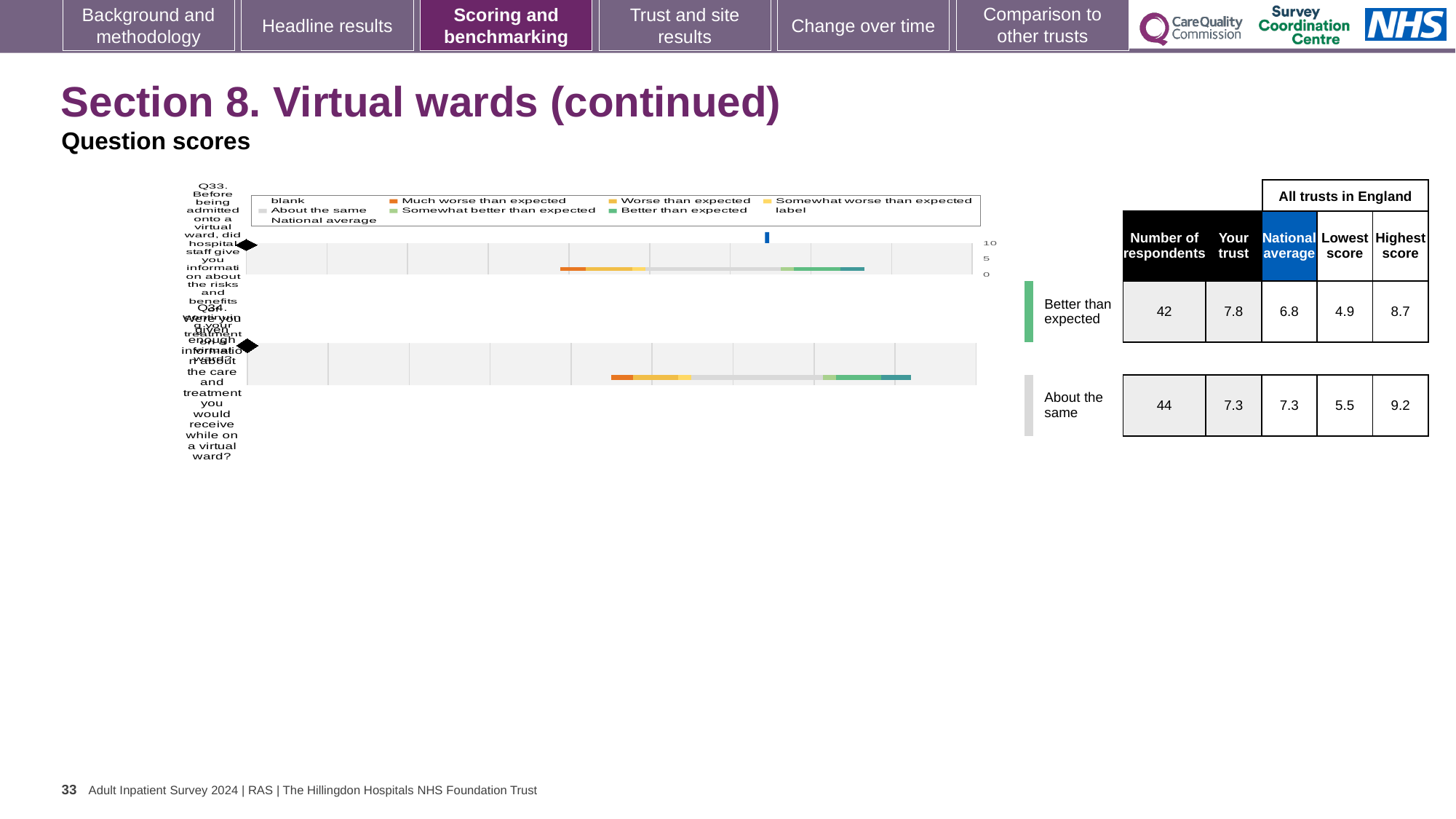
What is the highest score among all trusts in England for Q34? 9.2 For Q33, is the trust's score higher or lower than the national average? higher How many respondents answered Q34? 44 What is the 'Your trust' score for Q33 (information about the risks and benefits of a virtual ward)? 7.8 Which question has more respondents, Q33 or Q34? Q34 How many questions (categories) are plotted in the chart? 2 What is the national average score for Q33? 6.8 What kind of chart is used to show the question scores on this slide? bar chart Which benchmark category is Q33 placed in? Better than expected What is the lowest score among all trusts in England for Q33? 4.9 What is the 'Your trust' score for Q34 (enough information about care and treatment on a virtual ward)? 7.3 What is the difference between the trust's score and the national average for Q33? 1.0